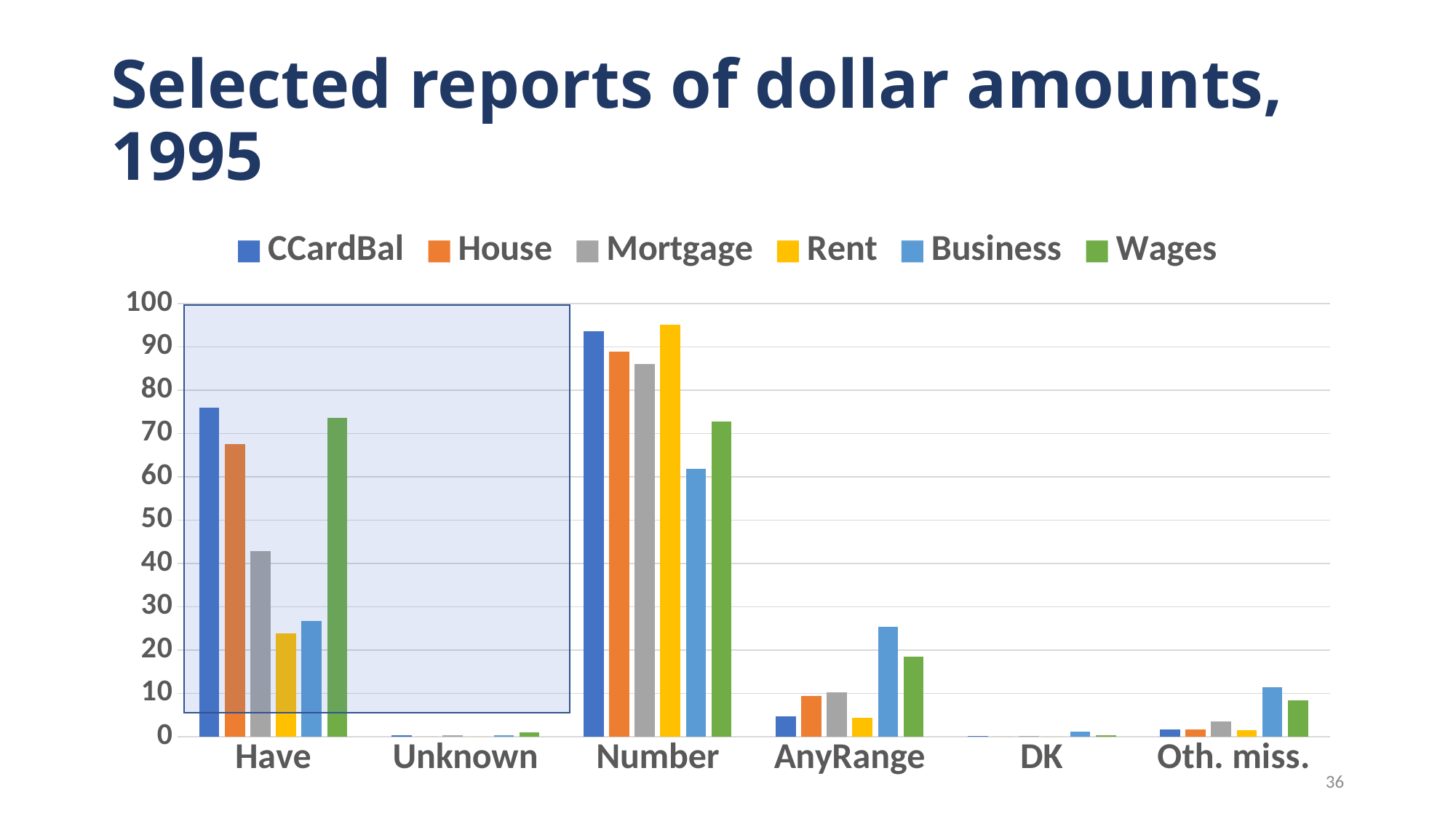
What kind of chart is shown on the slide? bar chart What colour represents the Rent series in the legend? yellow How many categories are shown along the x axis? 6 How many series does the legend list? 6 Is the value for Mortgage in the Have category greater or less than 50? less In the Have category, which is larger: House or Wages? Wages Which series has the highest value in the AnyRange category? Business Which series has the lowest value in the Number category? Business Is the value for CCardBal in the Have category greater or less than 70? greater Is the value for Business in the AnyRange category greater or less than 20? greater